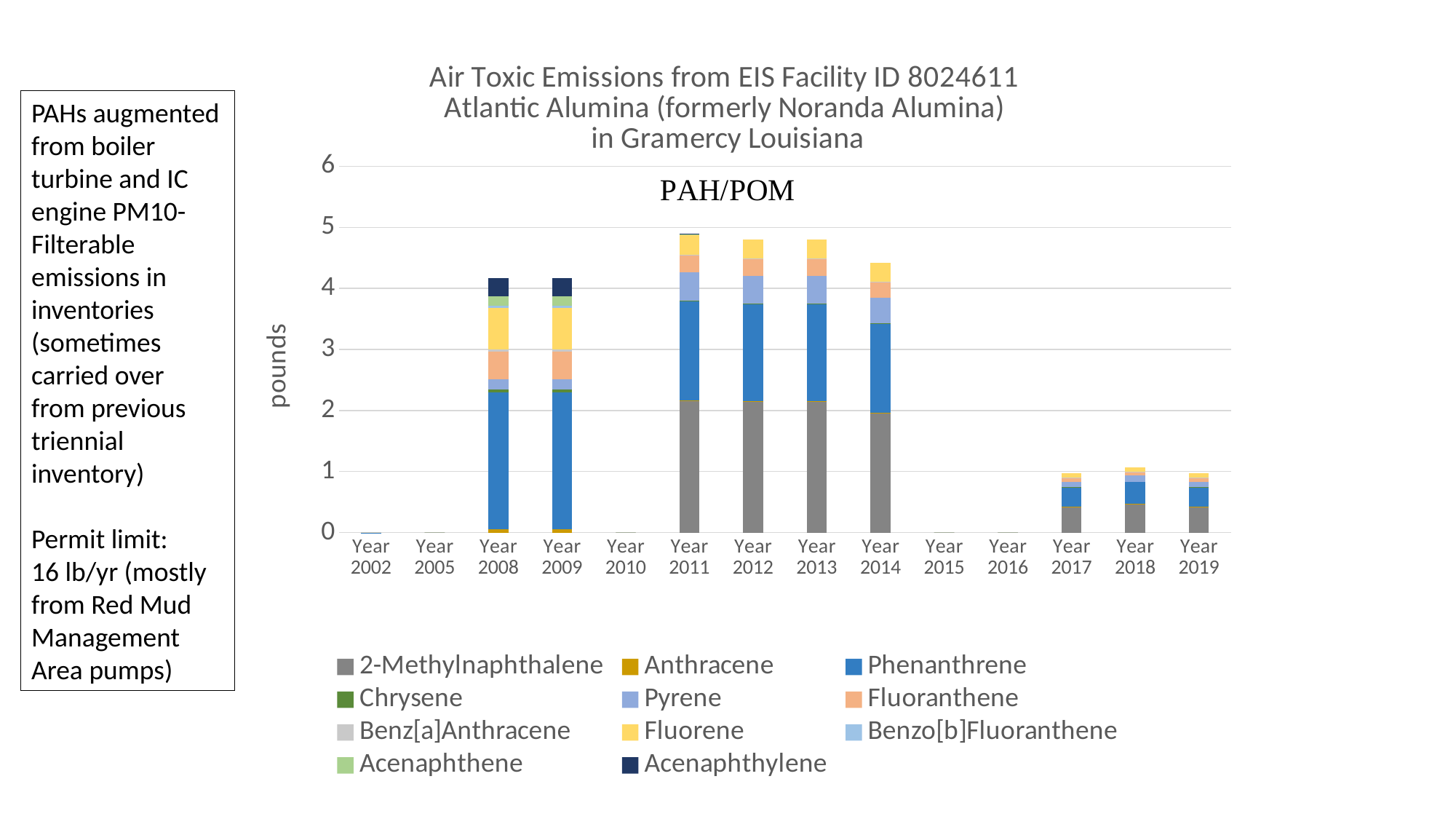
Which colour represents 2-Methylnaphthalene in the legend? Grey Which series makes up the largest part of the Year 2011 bar? 2-Methylnaphthalene How many years are shown on the x axis of the chart? 14 Is the total value for Year 2011 greater or less than 4? greater Is the total value for Year 2012 greater or less than 5? less What kind of chart is shown on the slide? Stacked bar chart How many series does the chart's legend list? 11 Which has the larger total, Year 2018 or Year 2014? Year 2014 Is the total value for Year 2014 greater or less than 4? greater What is the label on the y axis of the chart? pounds Which has the larger total, Year 2011 or Year 2017? Year 2011